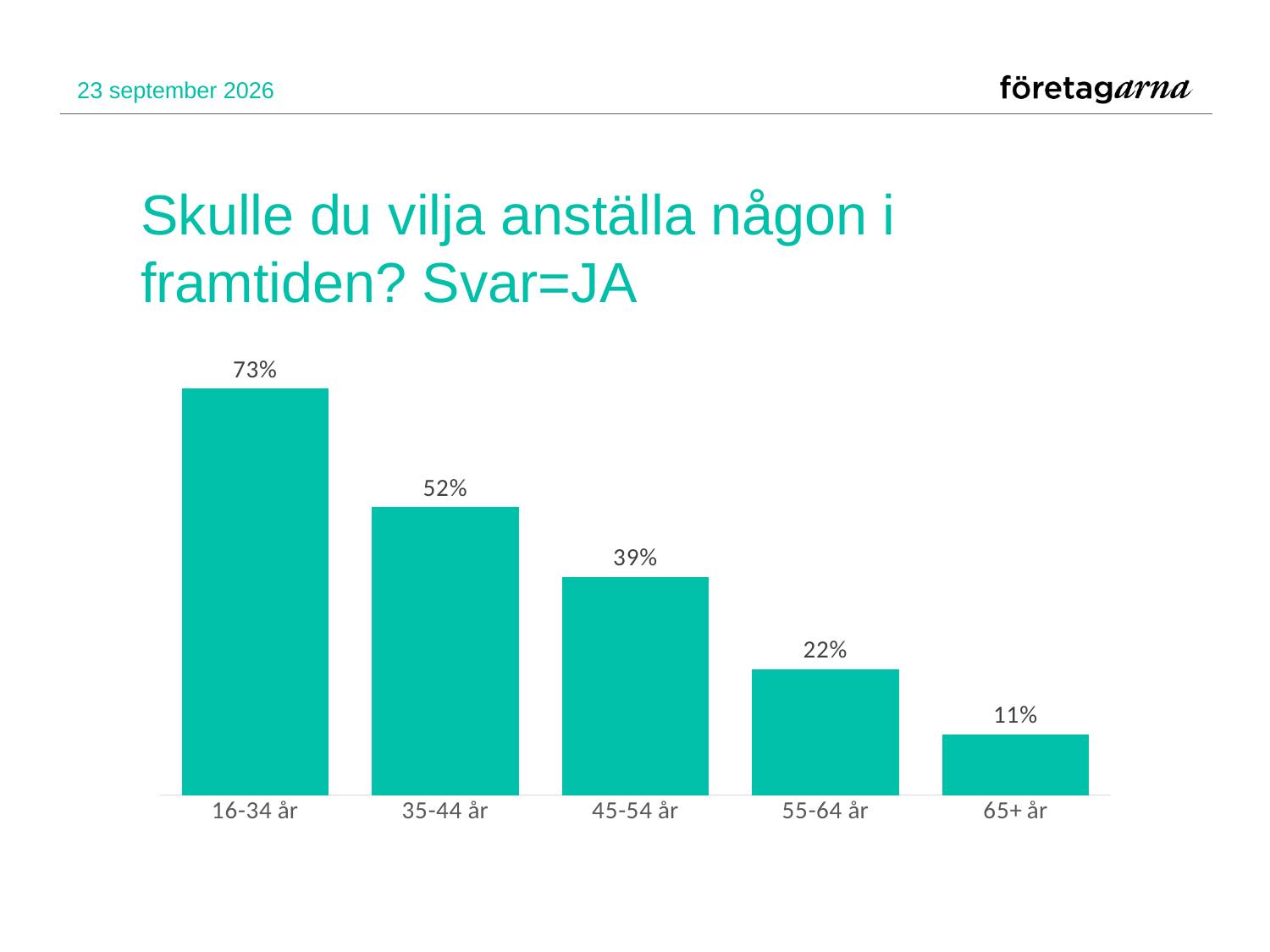
Which age group has the highest value? 16-34 år What is the value for the 65+ år age group? 11% Do the values rise or fall as the age groups get older along the x axis? Fall How many age groups are shown in the chart? 5 What is the difference between the values for 55-64 år and 65+ år? 11 percentage points What is the title of the slide containing the chart? Skulle du vilja anställa någon i framtiden? Svar=JA What kind of chart is shown on the slide? Bar chart What is the difference between the values for 16-34 år and 35-44 år? 21 percentage points Which is larger, the value for 35-44 år or the value for 55-64 år? 35-44 år Which age group has the lowest value? 65+ år What is the value for the 16-34 år age group? 73% What is the value for the 45-54 år age group? 39%